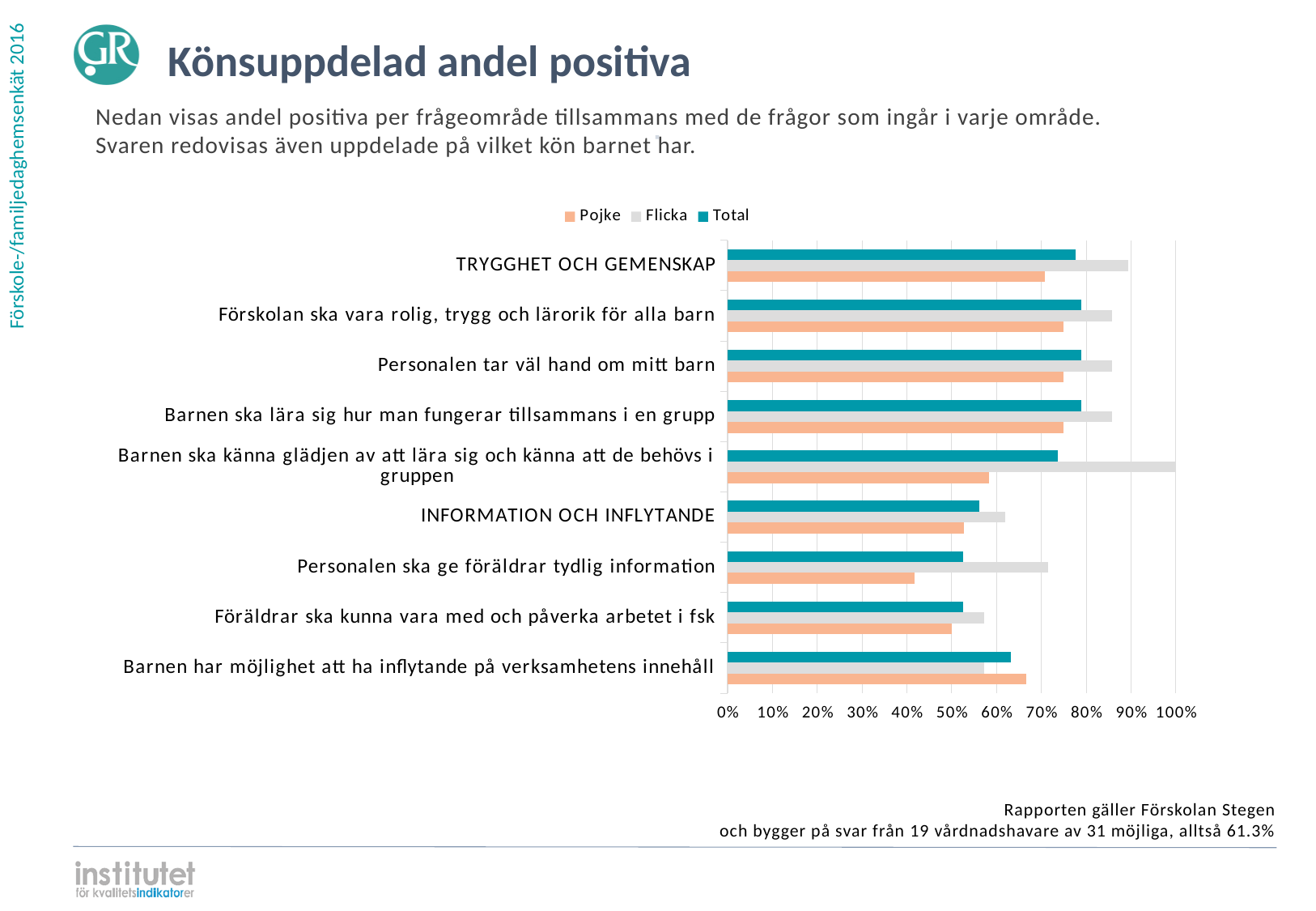
What kind of chart is shown on the slide? bar chart Is the Pojke value for 'Personalen ska ge föräldrar tydlig information' greater or less than 50%? less For 'TRYGGHET OCH GEMENSKAP', which is larger, the Flicka value or the Pojke value? Flicka What are the three series named in the legend? Pojke, Flicka, Total Which category has the highest Flicka value? Barnen ska känna glädjen av att lära sig och känna att de behövs i gruppen For 'Barnen har möjlighet att ha inflytande på verksamhetens innehåll', which is larger, the Pojke value or the Flicka value? Pojke Is the Total value for 'INFORMATION OCH INFLYTANDE' greater or less than 60%? less What is the Flicka value for 'Barnen ska känna glädjen av att lära sig och känna att de behövs i gruppen'? 100% How many series does the legend list? 3 Is the Flicka value for 'TRYGGHET OCH GEMENSKAP' greater or less than 80%? greater How many categories are plotted on the chart? 9 Which category has the lowest Pojke value? Personalen ska ge föräldrar tydlig information